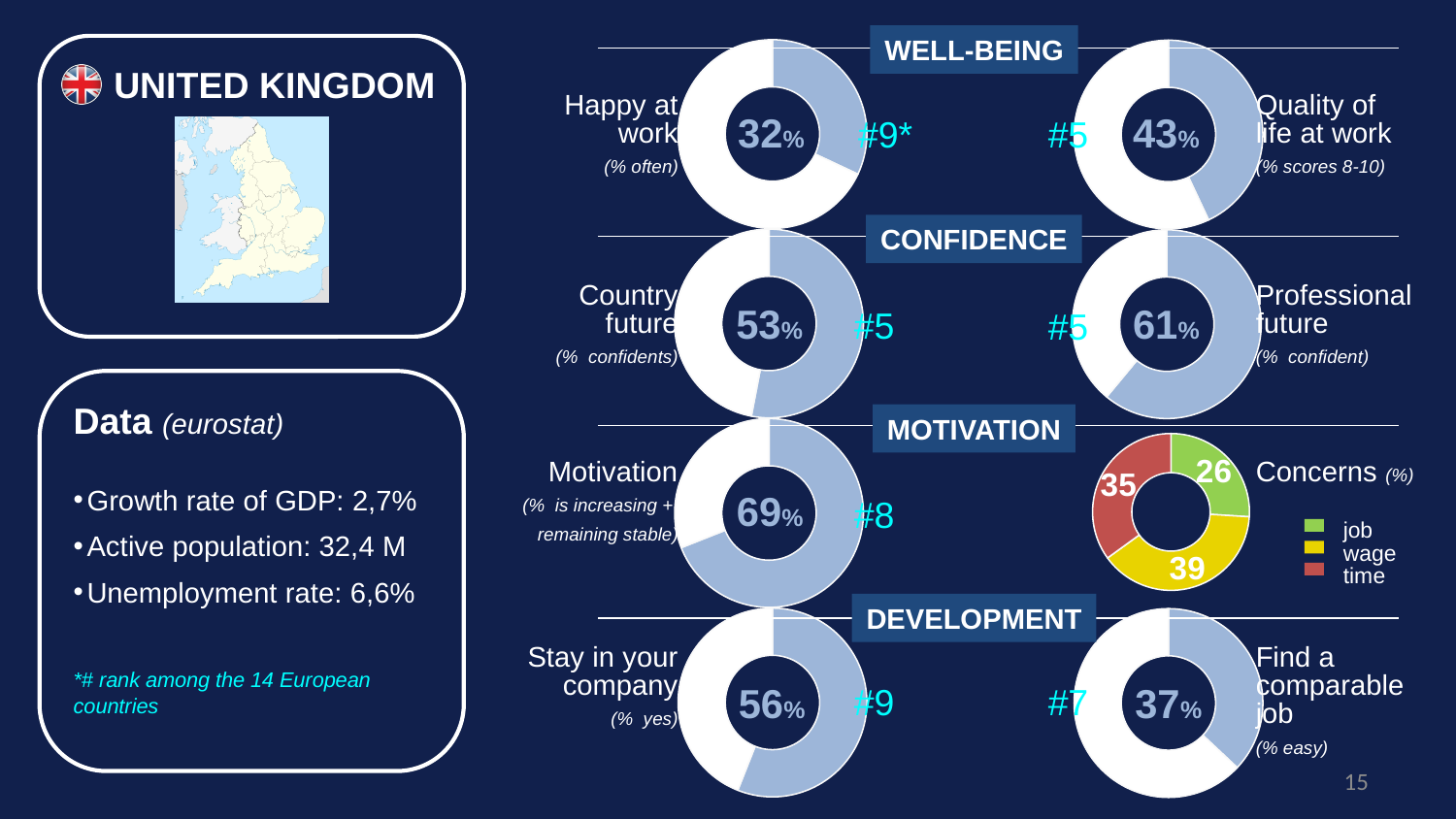
On the "Concerns" donut chart, what is the difference between the values for wage and job? 13 On the "Motivation" donut chart, what percentage is shown? 69% On the "Quality of life at work" donut chart, what percentage is shown? 43% Which is larger: the percentage on the "Stay in your company" chart or the percentage on the "Find a comparable job" chart? Stay in your company On the "Happy at work" donut chart, what percentage is shown in the centre? 32% What type of chart is used for "Find a comparable job"? Donut chart On the "Concerns" donut chart, which concern has the lowest value? job On the "Concerns" donut chart, which concern has the highest value? wage On the "Concerns" donut chart, what is the value for wage? 39 On the "Country future" donut chart, what percentage of respondents are confident? 53% On the "Professional future" donut chart, what percentage is shown? 61% On the "Concerns" donut chart, how many categories does the legend list? 3